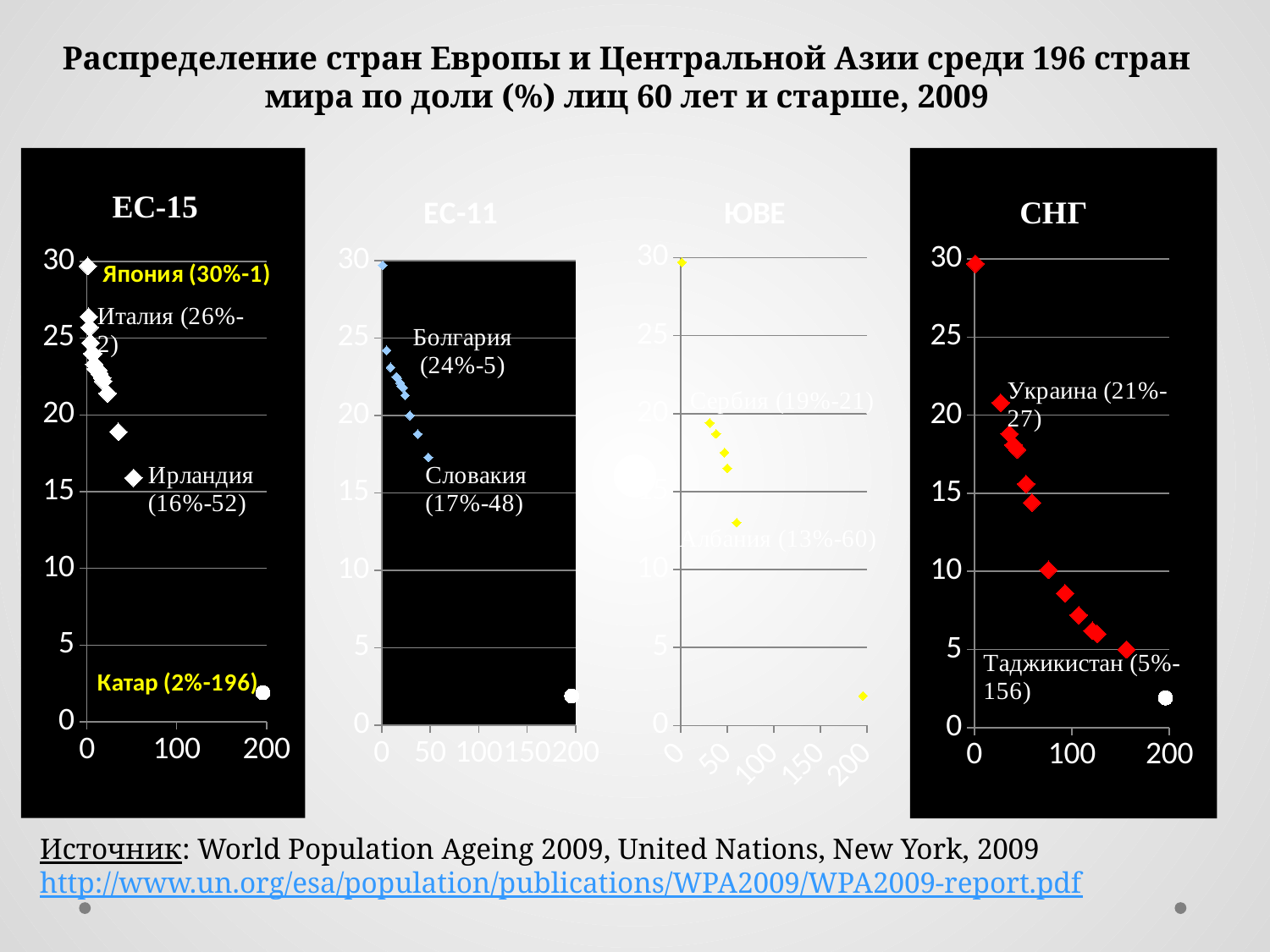
In the ЕС-11 chart, what rank is labelled for Словакия? 48 How many charts are shown on the slide? 4 In the СНГ chart, what rank is labelled for Таджикистан? 156 In the ЕС-15 chart, what share is labelled for Ирландия? 16% In the СНГ chart, which has the larger share, Украина or Таджикистан? Украина In the ЕС-15 chart, what rank is labelled for Катар? 196 In the ЕС-11 chart, what share and rank are labelled for Болгария? 24%-5 In the СНГ chart, do the values rise or fall as the rank on the x axis increases? fall What kind of chart is the ЕС-15 chart? scatter chart In the СНГ chart, what share is labelled for Украина? 21% In the ЕС-15 chart, what is the difference in share between Италия (26%) and Ирландия (16%)? 10% In the ЕС-15 chart, what share of persons aged 60 and over is labelled for Япония? 30%